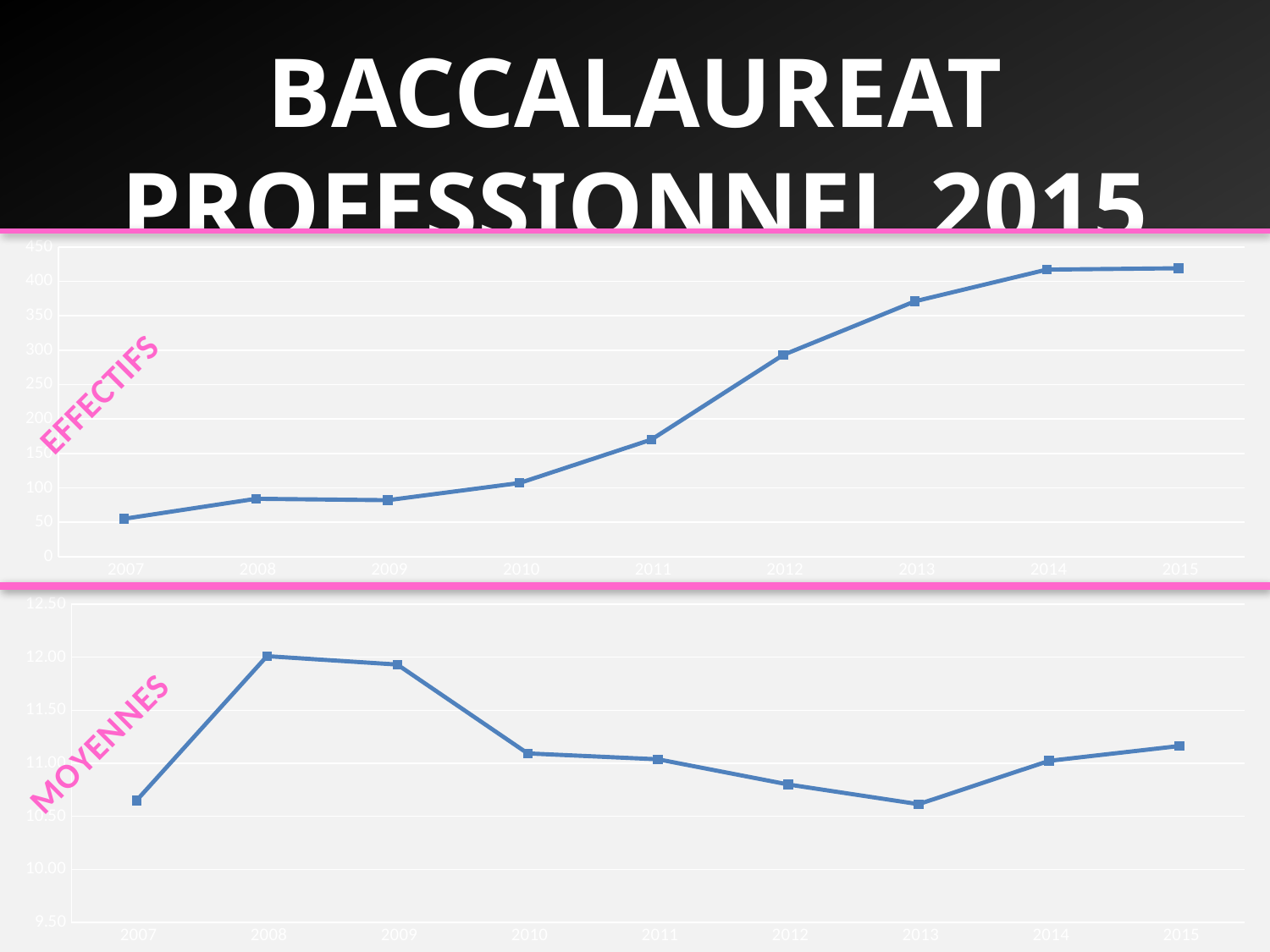
In the EFFECTIFS chart, is the value for 2013 greater or less than 350? greater In the EFFECTIFS chart, do the values generally rise or fall from 2007 to 2015? rise In the EFFECTIFS chart, is the value for 2009 greater or less than 100? less In the EFFECTIFS chart, is the value for 2012 greater or less than 250? greater How many years are plotted on the x axis of the EFFECTIFS chart? 9 In the MOYENNES chart at the bottom of the slide, which year has the highest value? 2008 What is the label written in pink beside the bottom chart? MOYENNES In the EFFECTIFS chart, which is larger, the value for 2011 or the value for 2012? 2012 What kind of chart is the EFFECTIFS chart at the top of the slide? line chart In the EFFECTIFS chart, which year has the lowest value? 2007